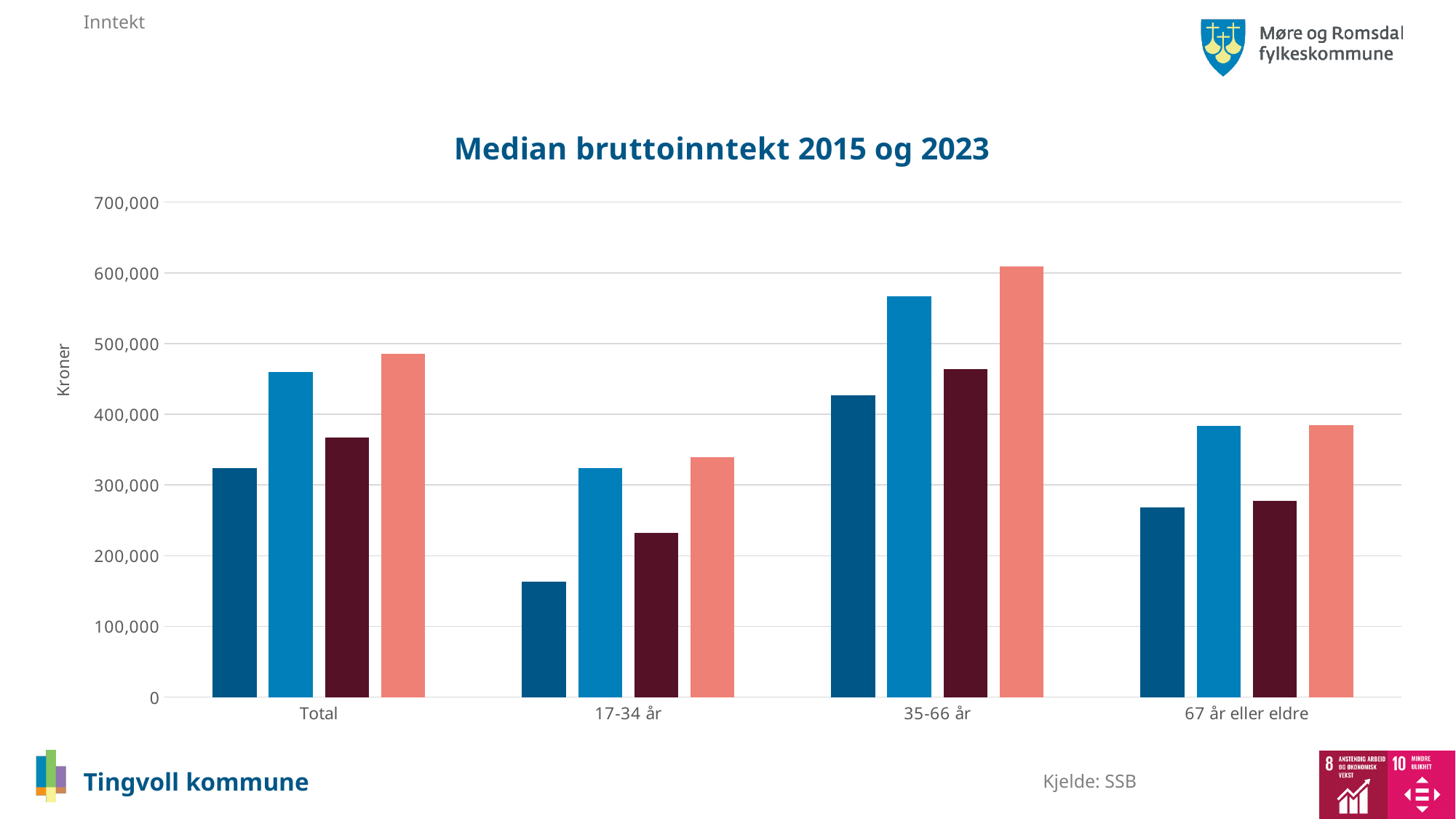
Is the value of the dark red bar for 67 år eller eldre greater or less than 300,000? less Is the value of the light blue bar for 35-66 år greater or less than 500,000? greater Is the value of the dark blue bar for 17-34 år greater or less than 200,000? less How many categories are shown along the x axis of the chart? 4 What is the title of the chart? Median bruttoinntekt 2015 og 2023 How many bars are plotted for each category in the chart? 4 Which category contains the shortest bar in the chart? 17-34 år What label is shown on the vertical axis of the chart? Kroner What kind of chart is shown on the slide? bar chart Which category contains the tallest bar in the chart? 35-66 år Which is larger: the light blue bar for Total or the light blue bar for 67 år eller eldre? Total Which is larger: the salmon bar for 35-66 år or the salmon bar for 17-34 år? 35-66 år